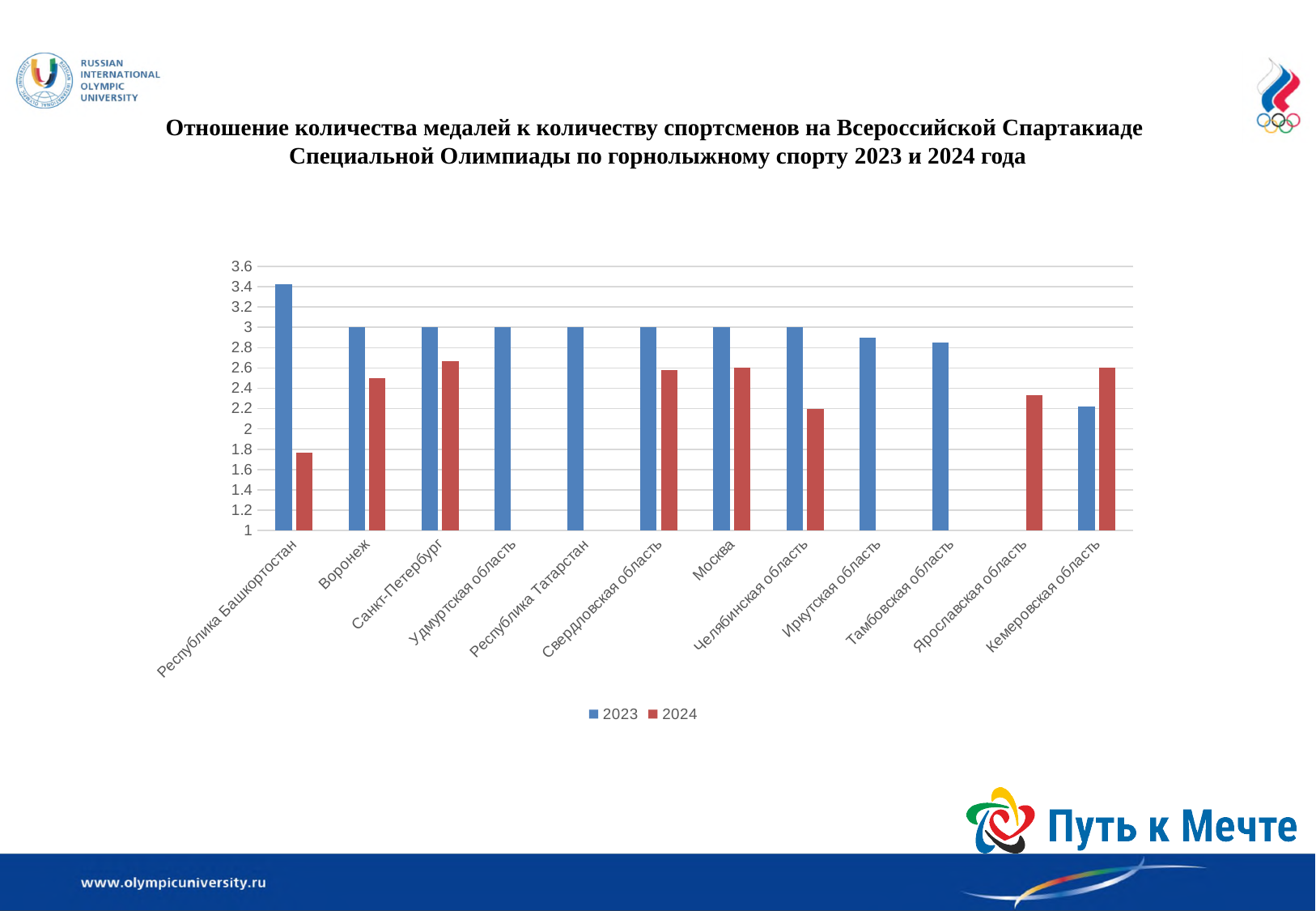
Is the 2024 value for Ярославская область greater or less than 2.2? greater What kind of chart is shown on the slide? bar chart Is the 2023 value for Республика Башкортостан greater or less than 3.2? greater How many series does the legend list? 2 Which region has the lowest value for 2024? Республика Башкортостан Is the 2023 value for Тамбовская область greater or less than 3? less Which region has the highest value for 2023? Республика Башкортостан For Челябинская область, which year has the larger value, 2023 or 2024? 2023 How many regions (categories) are shown on the x axis? 12 Which colour represents the 2024 series in the legend? red For Кемеровская область, which year has the larger value, 2023 or 2024? 2024